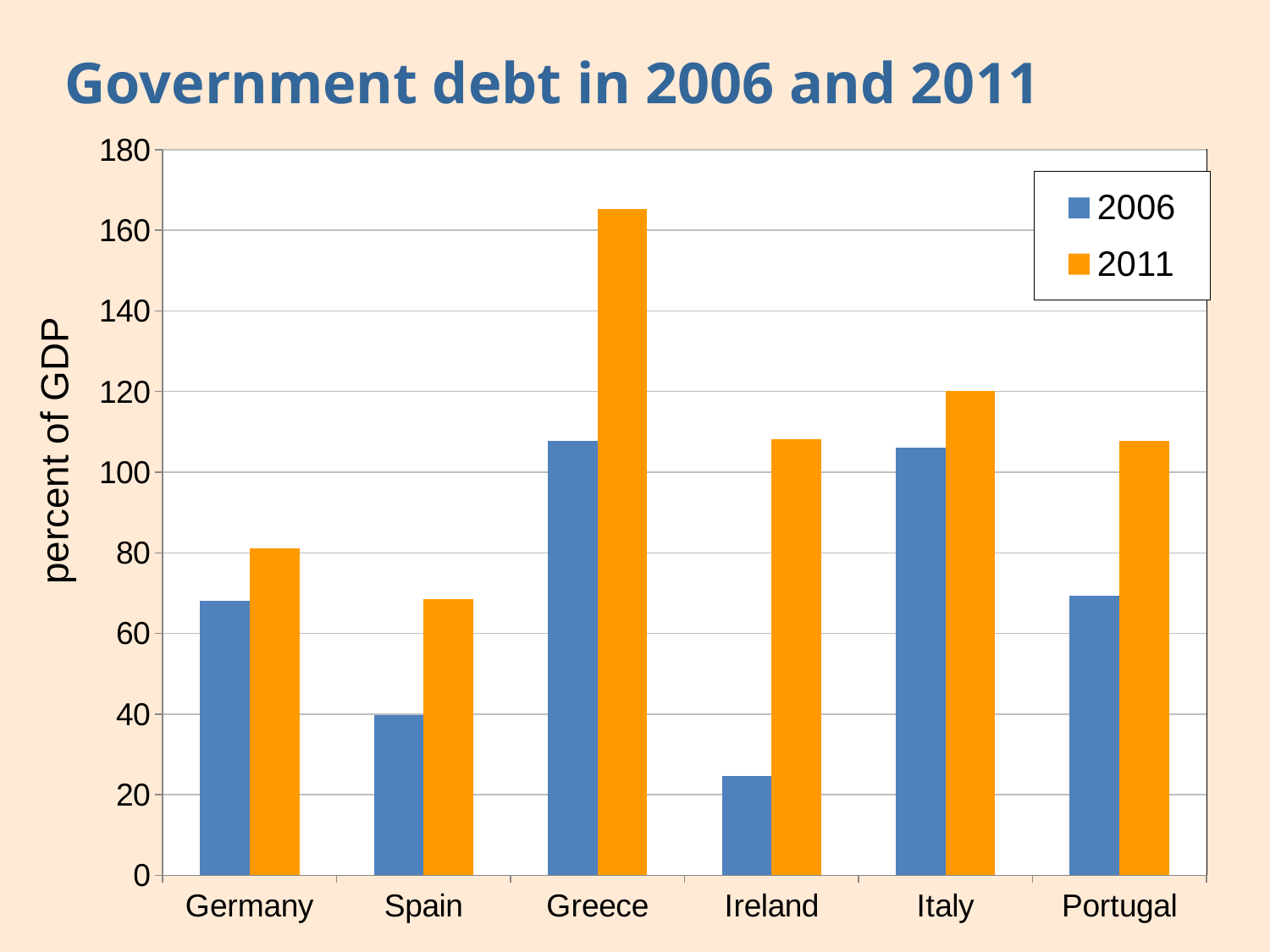
Is the 2006 value for Ireland greater or less than 40? less How many countries are shown on the x axis? 6 What kind of chart is shown on the slide? bar chart Which country has the lowest government debt in 2011? Spain Is the 2011 value for Ireland greater or less than 100? greater Is the 2006 value for Portugal greater or less than 80? less What is the label on the vertical axis? percent of GDP Which is larger, the 2006 value for Germany or the 2006 value for Spain? Germany Which country has the lowest government debt in 2006? Ireland How many series does the legend list? 2 Which country has the highest government debt in 2011? Greece